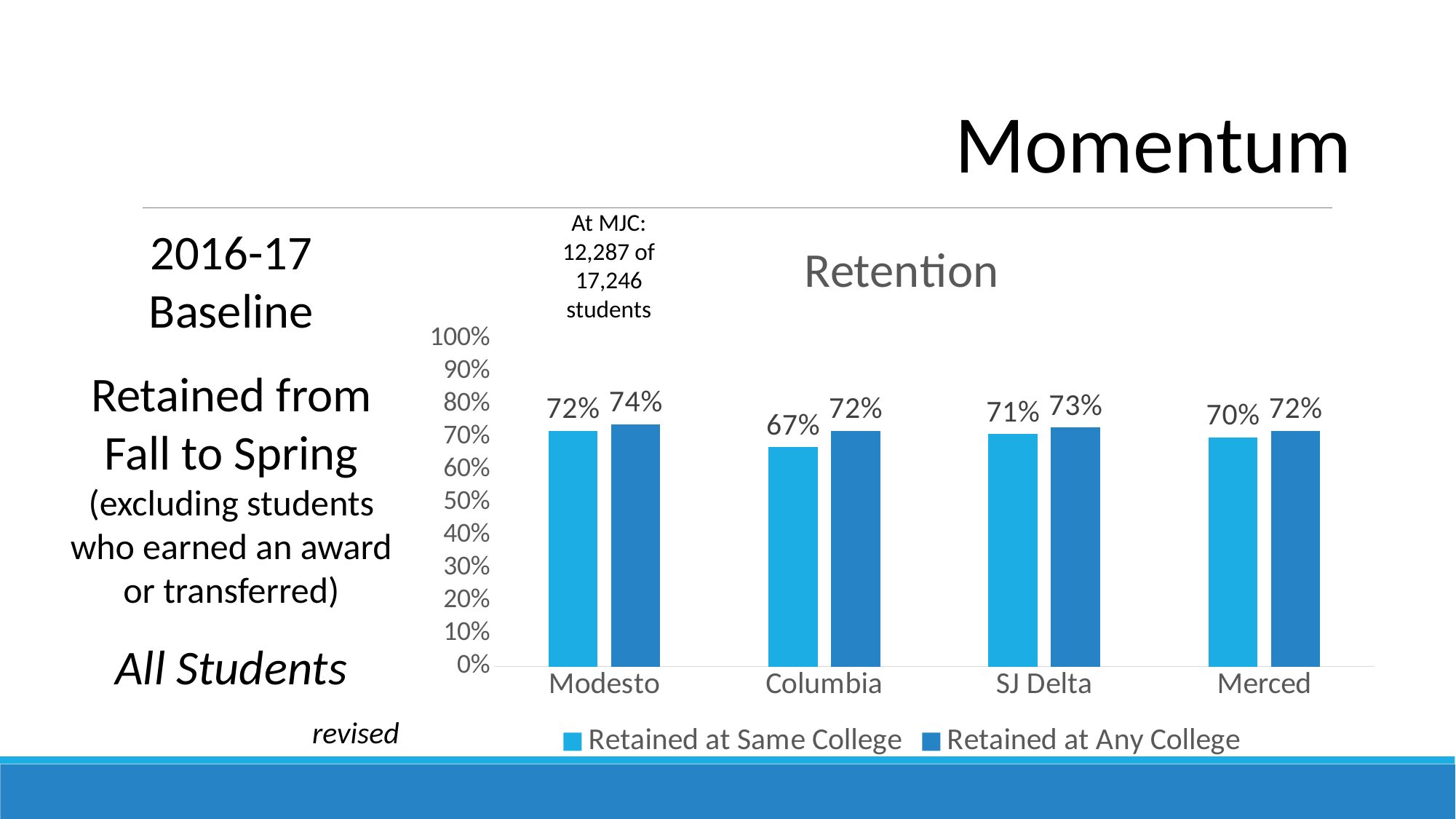
What is the value for Retained at Same College for SJ Delta? 71% What kind of chart is shown? Bar chart What is the difference between Retained at Any College and Retained at Same College for Columbia? 5% How many colleges are shown on the x axis? 4 What is the title of the chart? Retention Which college has the lowest value for Retained at Same College? Columbia What is the value for Retained at Any College for Modesto? 74% What is the value for Retained at Any College for Merced? 72% How many series does the legend list? 2 Which is larger for Merced: Retained at Same College or Retained at Any College? Retained at Any College What is the value for Retained at Same College for Columbia? 67% Which college has the highest value for Retained at Any College? Modesto